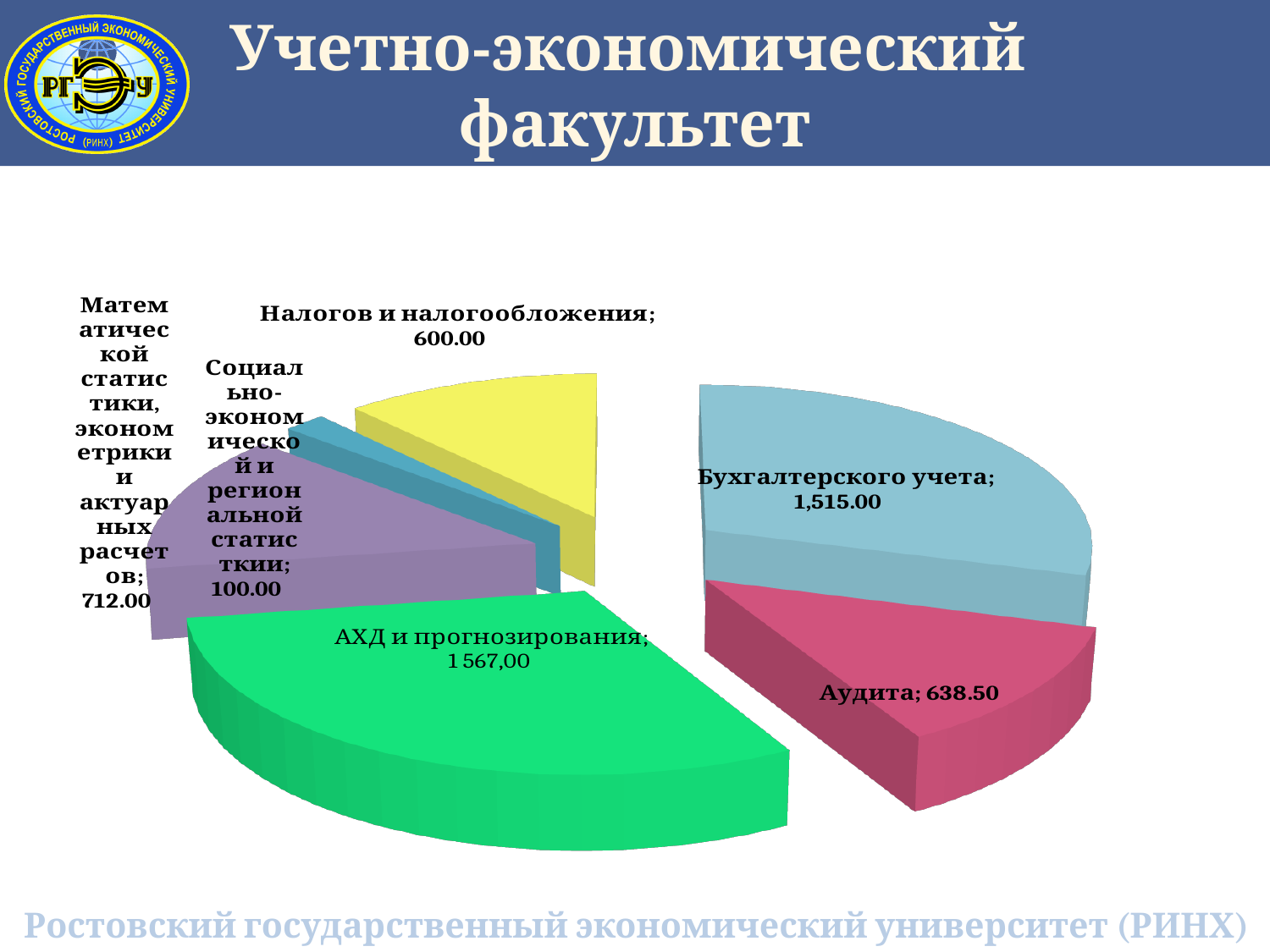
Which category has the smallest slice of the pie? Социально-экономической и региональной статистики What is the value for Аудита? 638.50 What is the difference between the values for Бухгалтерского учета and Аудита? 876.50 How many slices does the pie chart have? 6 What kind of chart is shown on the slide? pie chart What is the value for АХД и прогнозирования? 1 567,00 Which category has the largest slice of the pie? АХД и прогнозирования What colour is the slice for Аудита? red (pink) What is the value for Налогов и налогообложения? 600.00 What is the value for Социально-экономической и региональной статистики? 100.00 What is the value for Бухгалтерского учета? 1,515.00 Which is larger, the value for Математической статистики, эконометрики и актуарных расчетов or the value for Налогов и налогообложения? Математической статистики, эконометрики и актуарных расчетов